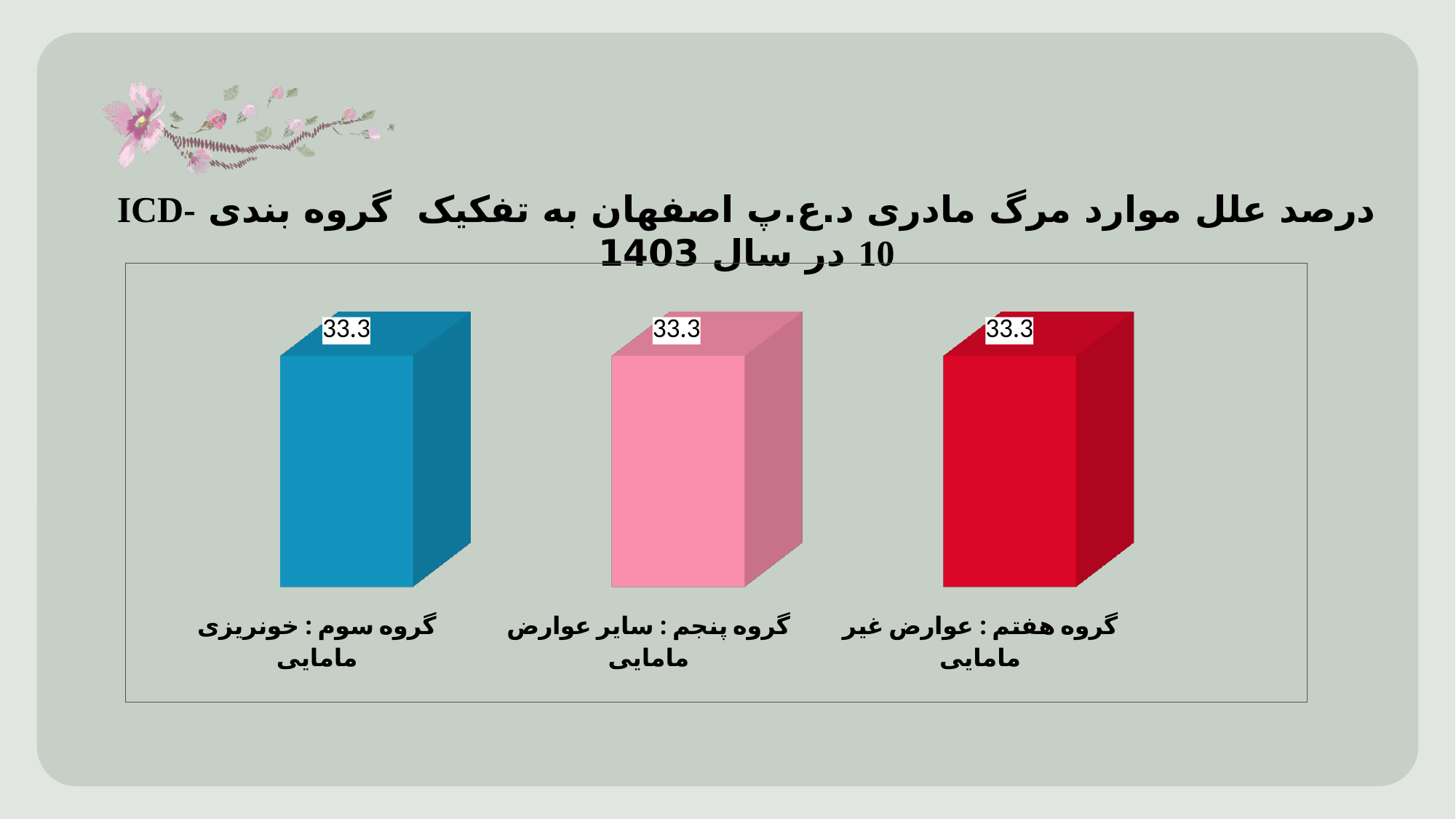
What kind of chart is shown on the slide? bar chart What is the value for گروه پنجم : سایر عوارض مامایی? 33.3 Which year is mentioned in the chart title? 1403 What is the value for گروه سوم : خونریزی مامایی? 33.3 What is the difference between the values for گروه سوم : خونریزی مامایی and گروه هفتم : عوارض غیر مامایی? 0 What colour is the bar for گروه پنجم : سایر عوارض مامایی? pink Do the three categories have the same value or different values? the same value What is the value for گروه هفتم : عوارض غیر مامایی? 33.3 How many categories are shown in the chart? 3 What is the sum of the three values shown in the chart? 99.9